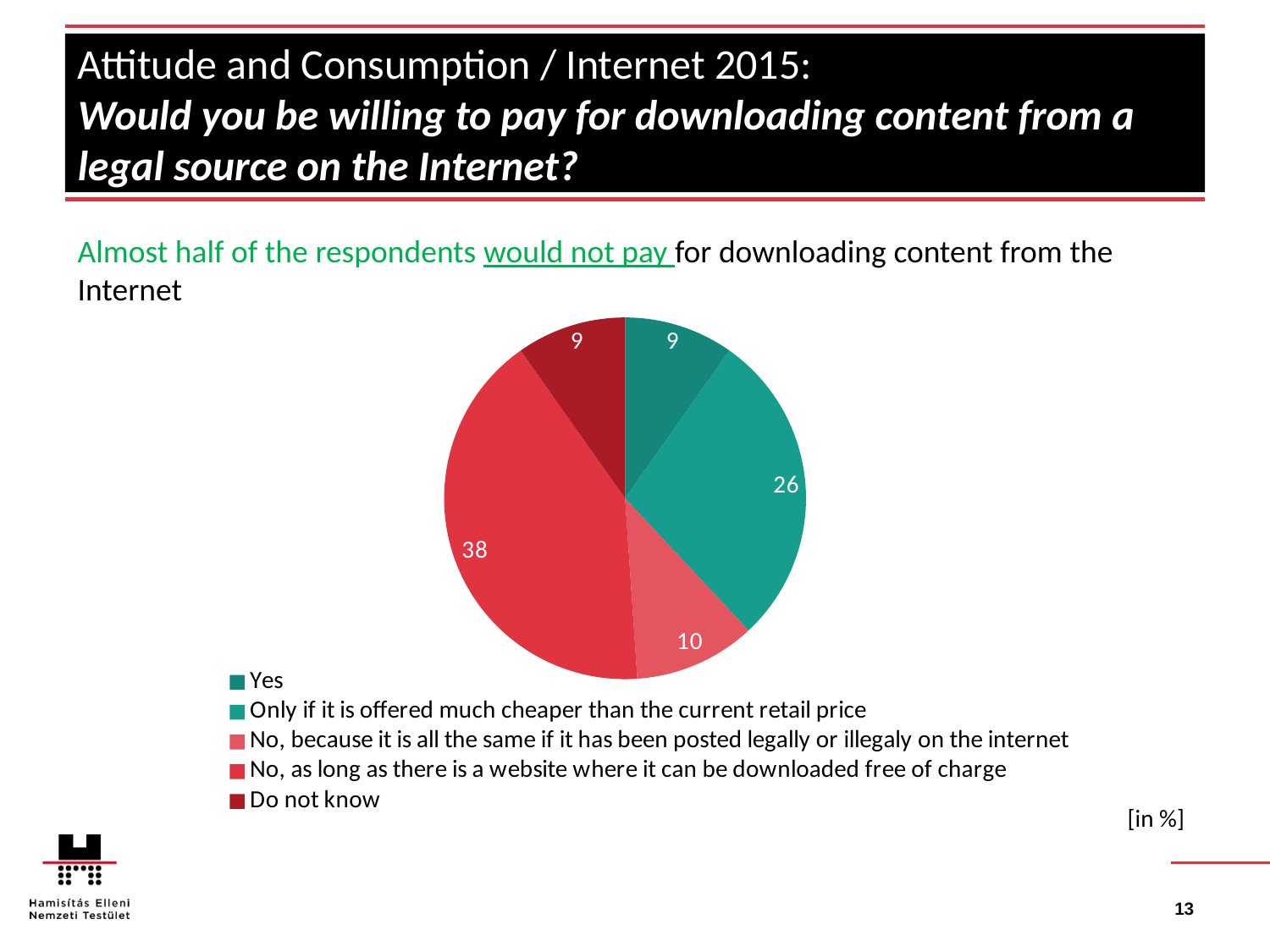
What is the value for "Only if it is offered much cheaper than the current retail price"? 26 Which legend entry is shown in the darkest red colour? Do not know What is the value for "Do not know"? 9 What type of chart is shown on the slide? Pie chart What is the value for "Yes"? 9 Which is larger: the value for "Only if it is offered much cheaper than the current retail price" or the value for "No, because it is all the same if it has been posted legally or illegaly on the internet"? Only if it is offered much cheaper than the current retail price What is the value for "No, as long as there is a website where it can be downloaded free of charge"? 38 What is the value for "No, because it is all the same if it has been posted legally or illegaly on the internet"? 10 Which response has the largest slice of the pie? No, as long as there is a website where it can be downloaded free of charge In what unit are the values in the pie chart given, according to the note on the slide? % How many slices does the pie chart have? 5 What is the difference between the value for "No, as long as there is a website where it can be downloaded free of charge" and the value for "Only if it is offered much cheaper than the current retail price"? 12